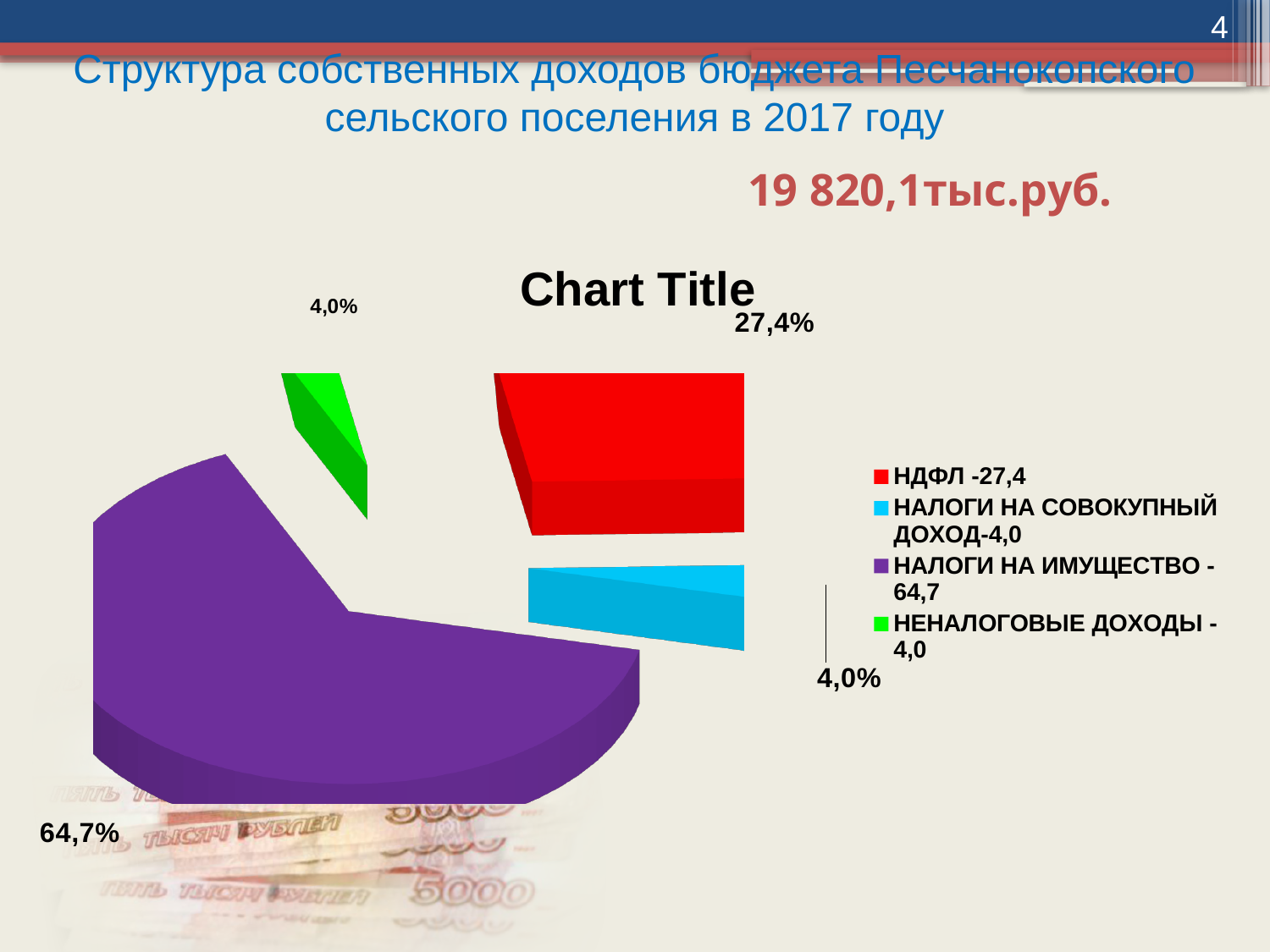
What kind of chart is shown on the slide? pie chart What colour is the slice for НДФЛ? red Which category has the largest slice of the pie? НАЛОГИ НА ИМУЩЕСТВО What is the title printed above the pie chart? Chart Title What share of the pie does НДФЛ have? 27,4% What share of the pie does НЕНАЛОГОВЫЕ ДОХОДЫ have? 4,0% Which is larger, the share for НДФЛ or the share for НЕНАЛОГОВЫЕ ДОХОДЫ? НДФЛ How many entries does the legend list? 4 What share of the pie does НАЛОГИ НА ИМУЩЕСТВО have? 64,7% What share of the pie does НАЛОГИ НА СОВОКУПНЫЙ ДОХОД have? 4,0% How many slices does the pie chart have? 4 What is the difference in percentage points between НАЛОГИ НА ИМУЩЕСТВО and НДФЛ? 37,3